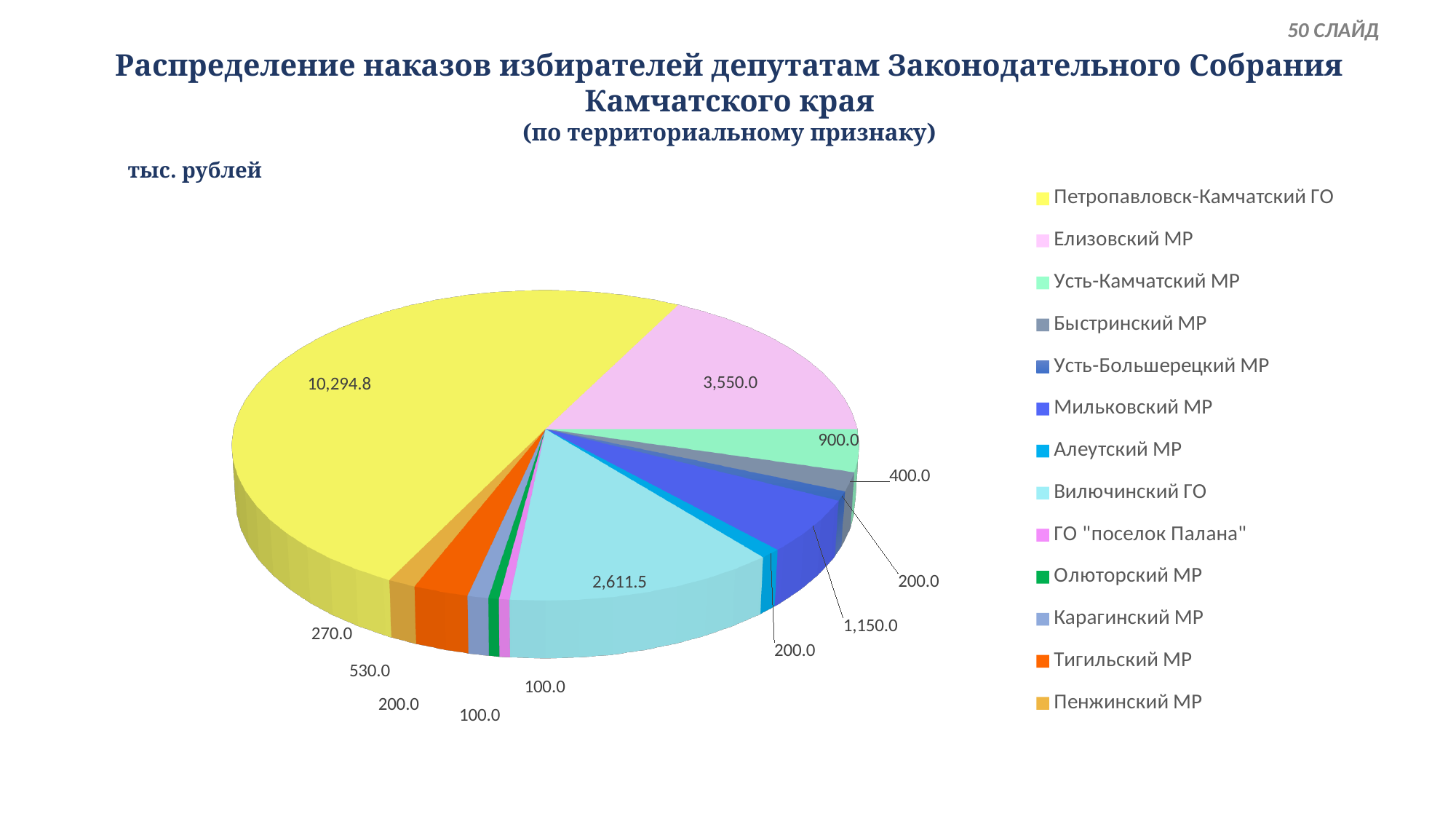
What is the difference between the values for Елизовский МР and Вилючинский ГО? 938.5 How many categories does the legend list? 13 What is the value for Тигильский МР? 530.0 Which is larger, the value for Усть-Камчатский МР or the value for Мильковский МР? Мильковский МР What is the value for Елизовский МР? 3,550.0 What is the value for Мильковский МР? 1,150.0 What is the difference between the values for Петропавловск-Камчатский ГО and Елизовский МР? 6,744.8 Which category has the largest slice of the pie? Петропавловск-Камчатский ГО What is the value for Вилючинский ГО? 2,611.5 In what units are the values on the chart given? тыс. рублей What kind of chart is shown on the slide? Pie chart What is the value for Петропавловск-Камчатский ГО? 10,294.8